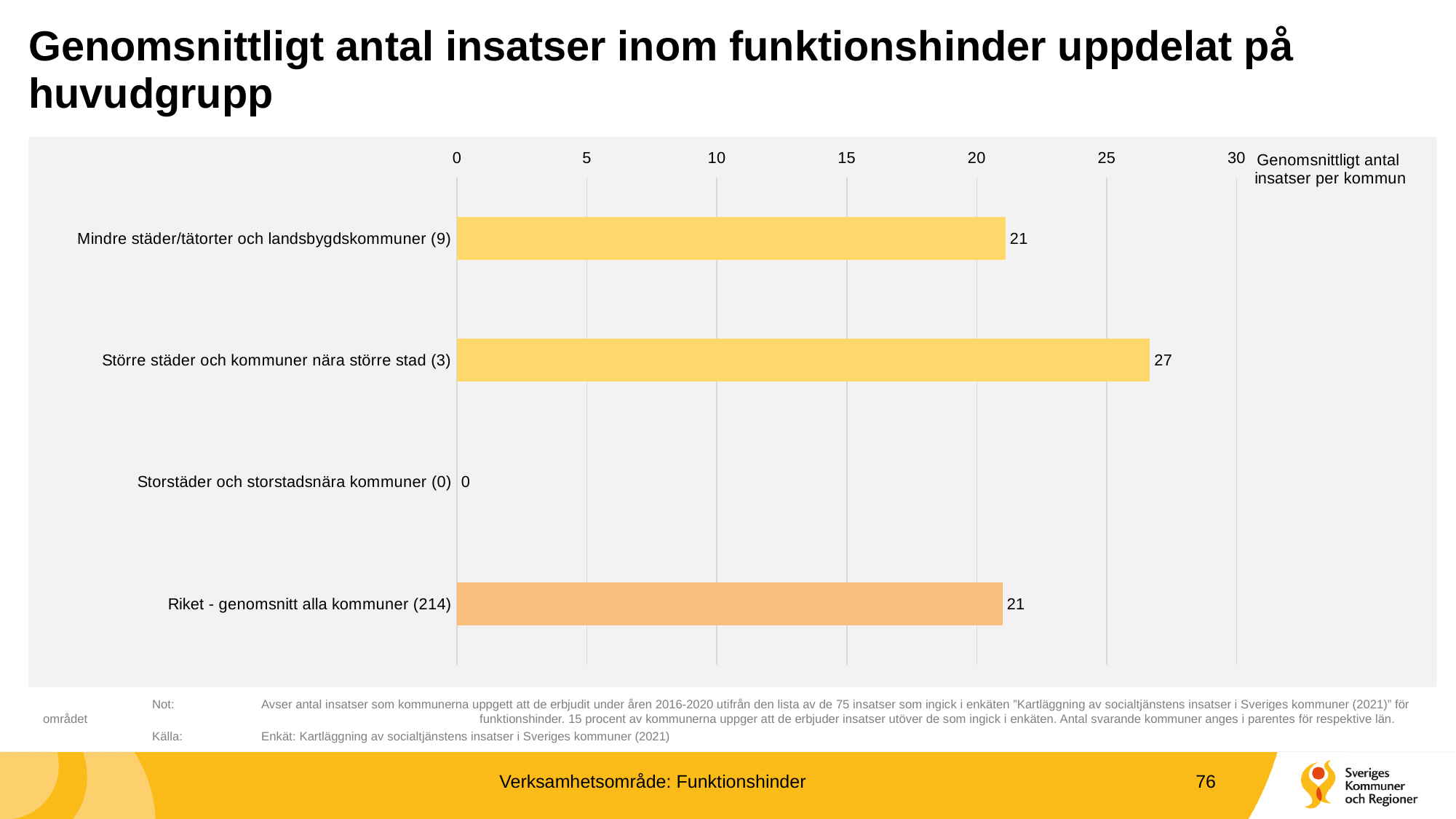
What is the value for Storstäder och storstadsnära kommuner (0)? 0 What is the value for Större städer och kommuner nära större stad (3)? 27 What is the label shown at the top right of the chart's axis? Genomsnittligt antal insatser per kommun Which is larger: the value for Större städer och kommuner nära större stad (3) or the value for Mindre städer/tätorter och landsbygdskommuner (9)? Större städer och kommuner nära större stad (3) What is the difference between the value for Större städer och kommuner nära större stad (3) and the value for Riket - genomsnitt alla kommuner (214)? 6 Which category has the lowest value? Storstäder och storstadsnära kommuner (0) What is the value for Riket - genomsnitt alla kommuner (214)? 21 Which category has the highest value? Större städer och kommuner nära större stad (3) What is the value for Mindre städer/tätorter och landsbygdskommuner (9)? 21 Is the value for Större städer och kommuner nära större stad (3) greater or less than 25? greater How many categories are shown in the chart? 4 What kind of chart is shown on the slide? bar chart